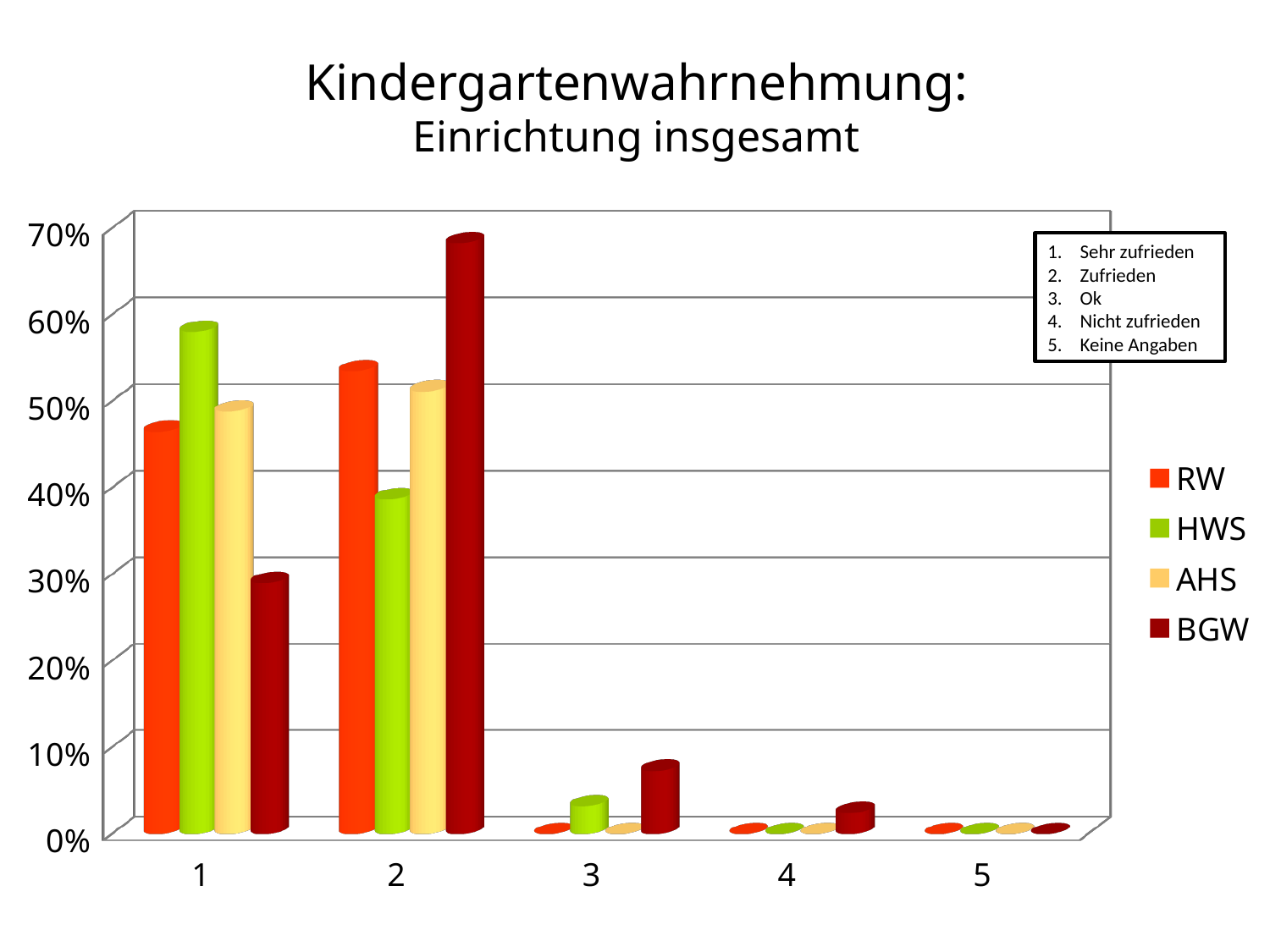
According to the text box on the chart, what does category 3 stand for? Ok How many series does the legend list? 4 Is the value for BGW in category 1 greater or less than 40%? less How many categories are shown on the x axis? 5 For category 2, which is larger: RW or HWS? RW Which series has the highest value for category 2? BGW Which series has the highest value for category 1? HWS Is the value for BGW in category 2 greater or less than 60%? greater What kind of chart is shown on the slide? bar chart Is the value for HWS in category 1 greater or less than 50%? greater For category 1, which is larger: RW or HWS? HWS Which series has the lowest value for category 1? BGW